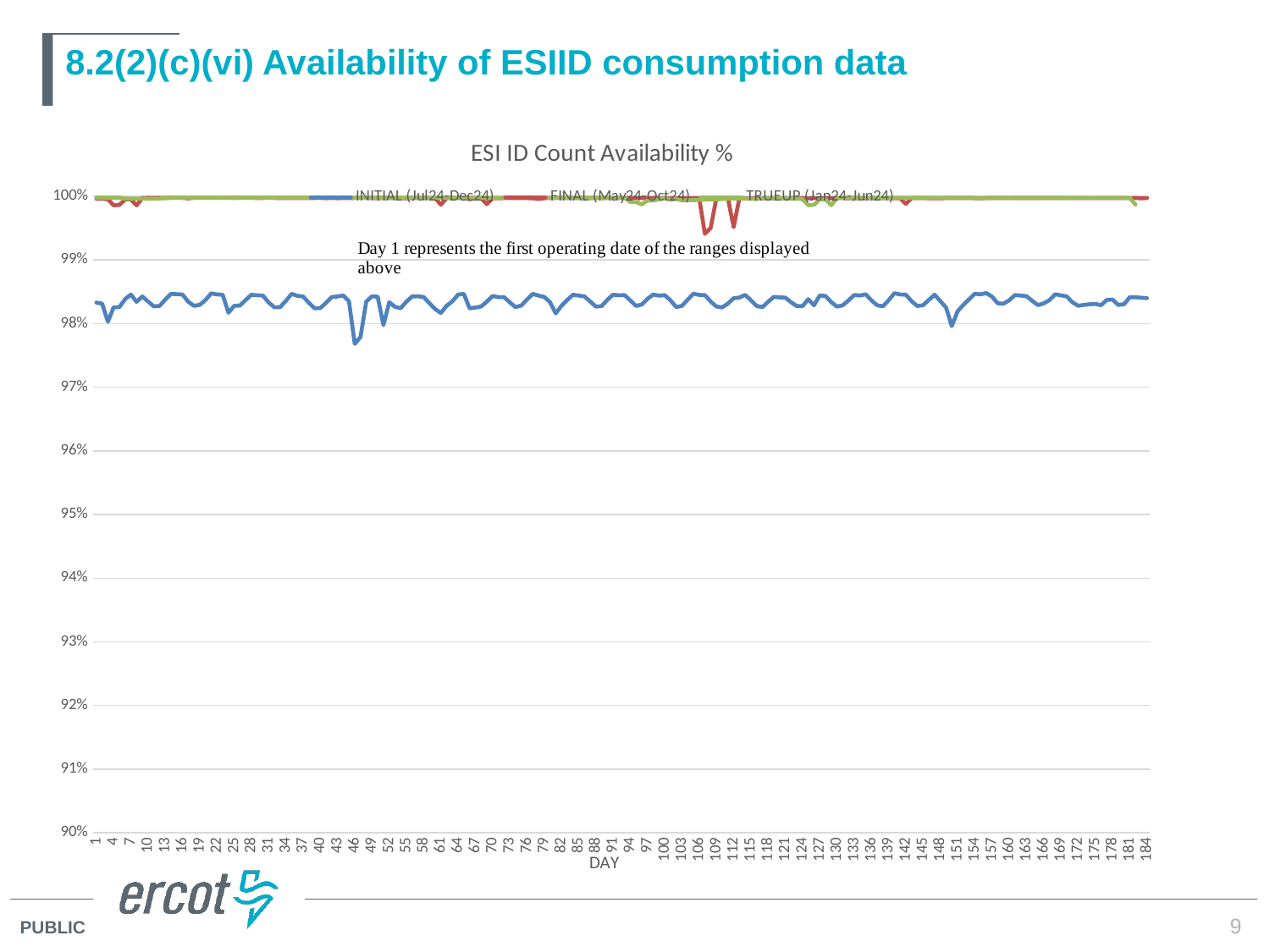
What is the lowest value shown on the y axis? 90% Which series has the lowest availability values across the days shown? INITIAL (Jul24-Dec24) Is the value for FINAL (May24-Oct24) on day 50 greater or less than 99%? greater Is the value for INITIAL (Jul24-Dec24) on day 100 greater or less than 99%? less What is the label of the x axis? DAY Is the value for TRUEUP (Jan24-Jun24) on day 100 greater or less than 99%? greater How many series does the legend of the ESI ID Count Availability % chart list? 3 On day 100, which is larger: the value for INITIAL (Jul24-Dec24) or the value for FINAL (May24-Oct24)? FINAL (May24-Oct24) What is the last day label shown on the x axis? 184 What is the title of the chart? ESI ID Count Availability % What kind of chart is shown on the slide? line chart